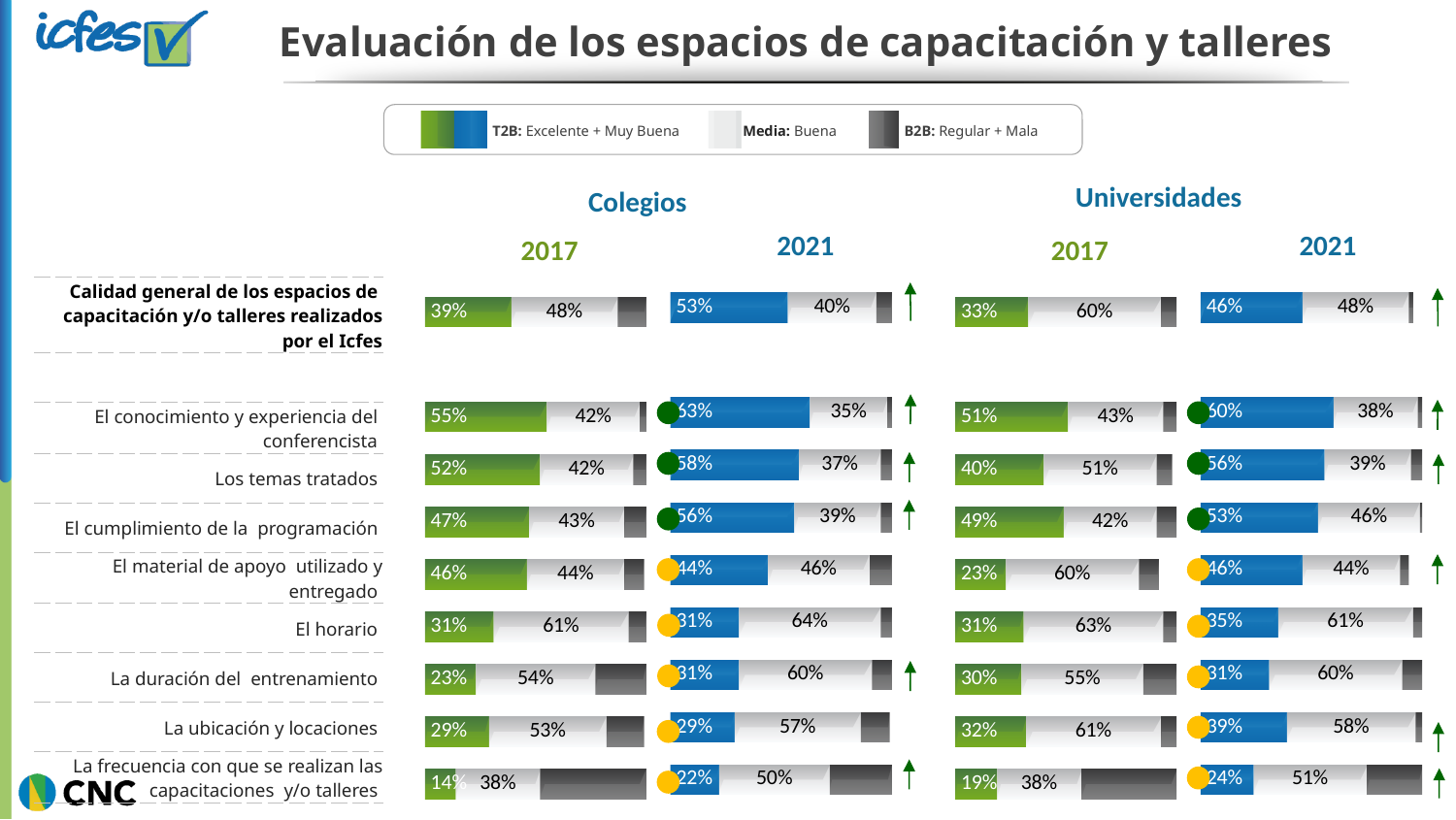
In the Universidades 2017 chart, what is the T2B value for 'La frecuencia con que se realizan las capacitaciones y/o talleres'? 19% In the Colegios 2021 chart, what is the T2B value for 'Calidad general de los espacios de capacitación y/o talleres realizados por el Icfes'? 53% What is the difference between the Colegios 2021 and Colegios 2017 T2B values for 'Los temas tratados'? 6 percentage points How many series does the legend at the top of the slide list? 3 In the Colegios 2017 chart, which item has the highest T2B value? El conocimiento y experiencia del conferencista What kind of chart is used on this slide? Stacked bar chart In the Universidades 2021 chart, which item has the lowest T2B value? La frecuencia con que se realizan las capacitaciones y/o talleres How many evaluated items (rows) are shown in the charts? 9 In the Universidades 2017 chart, what is the Media value for 'El material de apoyo utilizado y entregado'? 60% What is the combined T2B plus Media value for 'El cumplimiento de la programación' in the Universidades 2021 chart? 99% For 'El horario', which is larger: the Universidades 2021 T2B value or the Universidades 2017 T2B value? Universidades 2021 (35%) According to the legend, what does 'B2B' stand for? Regular + Mala